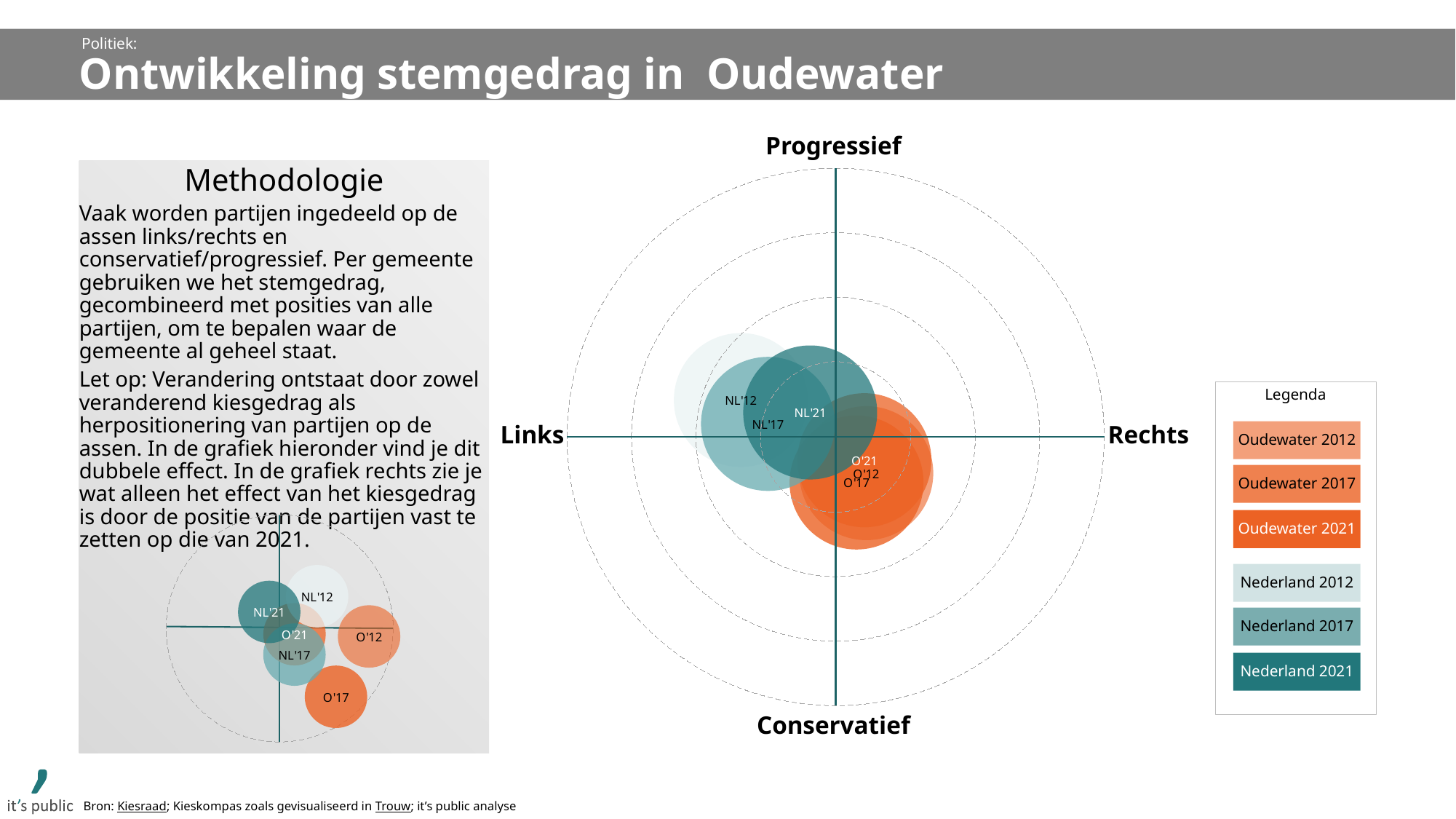
In the large chart, what label is at the right end of the horizontal axis? Rechts In the large chart, in which quadrant do the Nederland bubbles (NL'12, NL'17, NL'21) lie? Links / Progressief (upper left) In the large chart, what label is at the top of the vertical axis? Progressief In the large chart, how many labelled bubbles are plotted? 6 In the large chart, in which quadrant do the Oudewater bubbles (O'12, O'17, O'21) lie? Rechts / Conservatief (lower right) What kind of chart is the large chart on the right of the slide? bubble chart Which legend entry is shown in the darkest teal colour? Nederland 2021 In the small chart in the left panel, which bubble is positioned furthest to the left? NL'21 In the small chart in the left panel, which bubble is positioned lowest (most conservatief)? O'17 In the small chart in the left panel, which bubble is positioned furthest to the right? O'12 In the large chart, which is positioned further to the right: O'21 or NL'21? O'21 How many entries does the legend (Legenda) list? 6